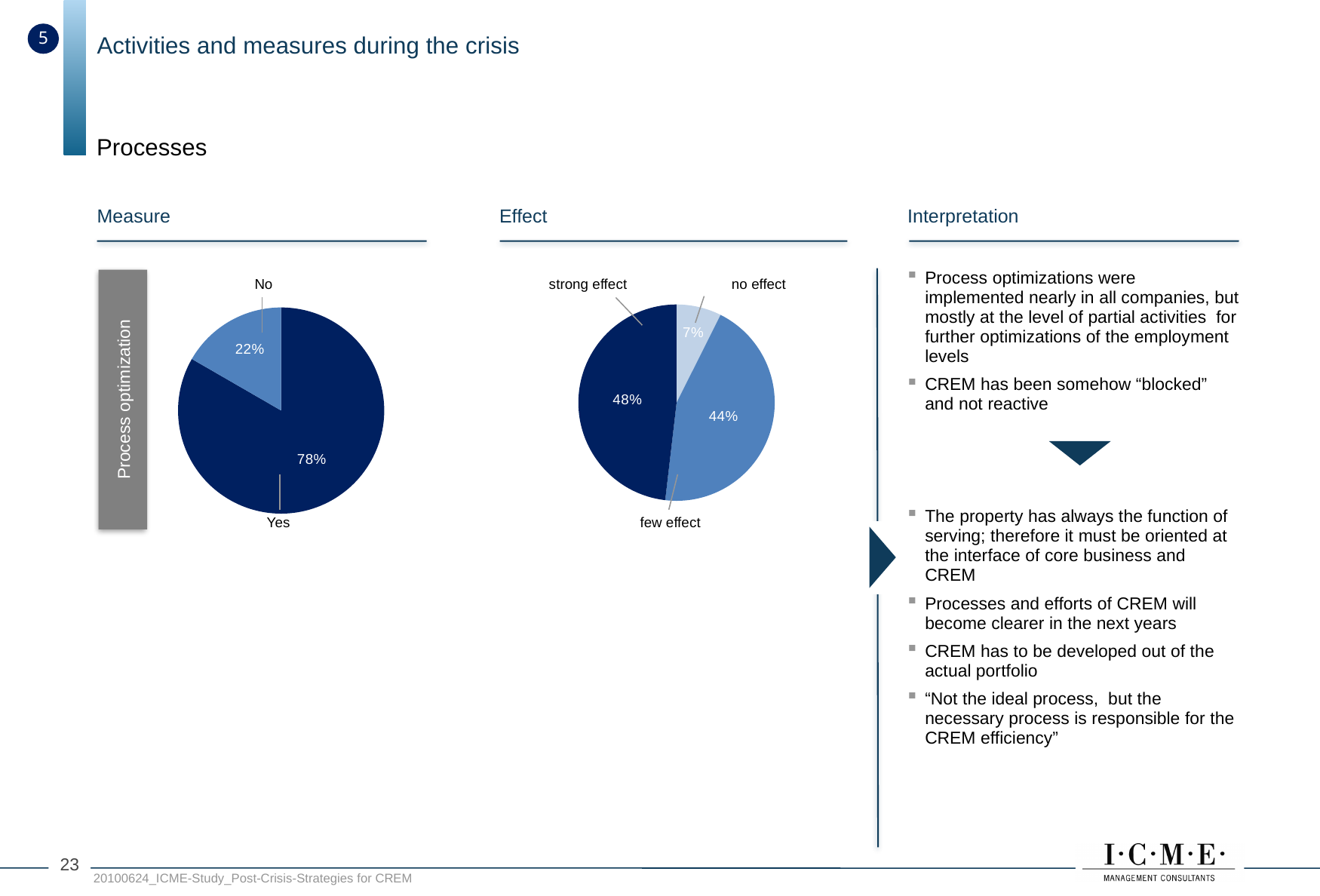
In the Measure pie chart on the left, which is larger, Yes or No? Yes In the Effect pie chart in the middle, what share reported a strong effect? 48% In the Effect pie chart in the middle, what share reported few effect? 44% In the Measure pie chart on the left, what share of respondents answered No? 22% In the Effect pie chart in the middle, what share reported no effect? 7% In the Effect pie chart in the middle, what is the difference in percentage points between strong effect and no effect? 41 In the Measure pie chart on the left, what is the difference in percentage points between Yes and No? 56 How many slices does the Effect pie chart in the middle have? 3 In the Effect pie chart in the middle, which category has the largest share? strong effect In the Effect pie chart in the middle, which category has the smallest share? no effect What type of chart is used under the Measure heading on the left? Pie chart In the Measure pie chart on the left, what share of respondents answered Yes to process optimization? 78%